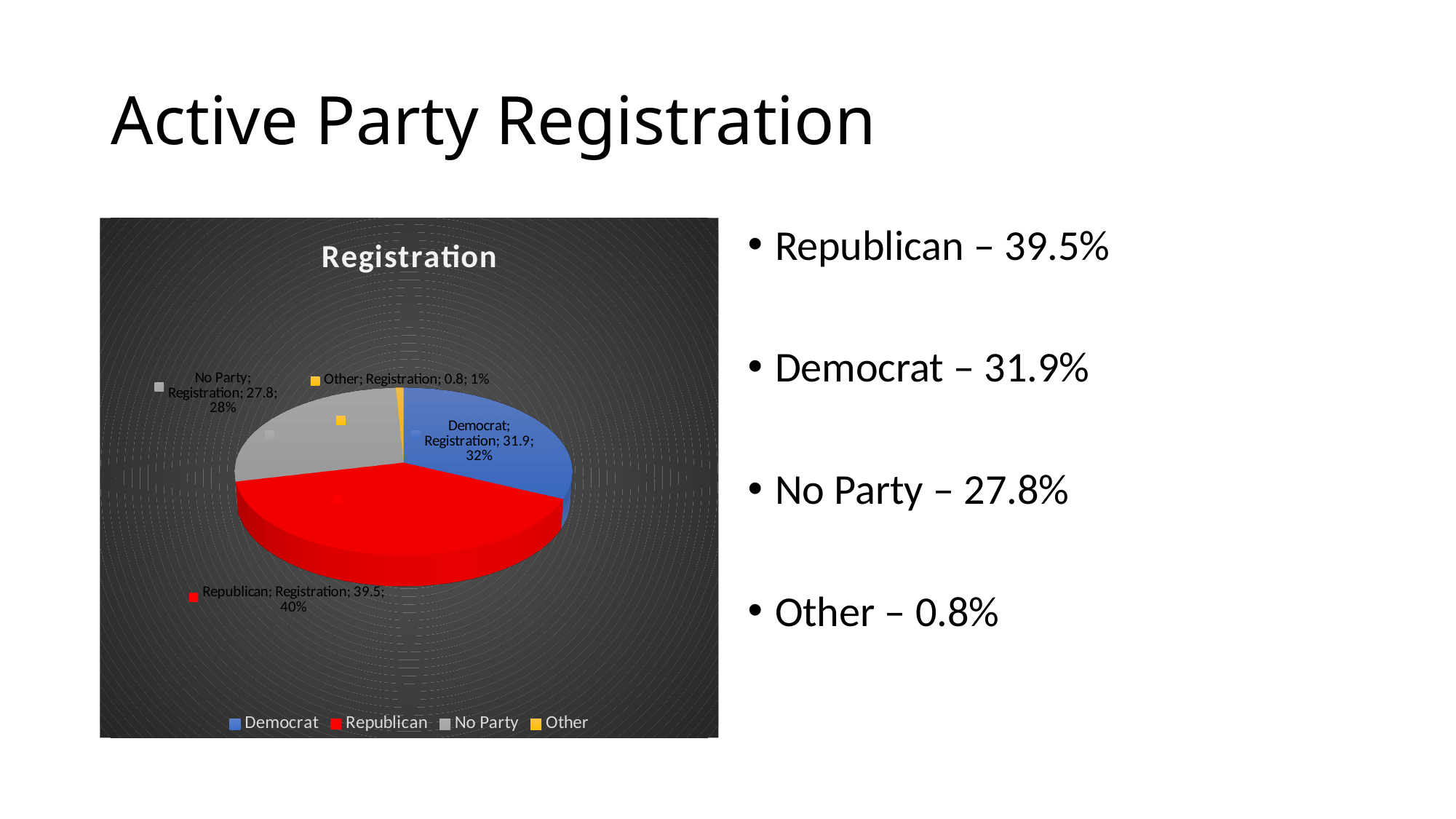
What is the Registration value for Republican in the pie chart? 39.5 What percentage share of the pie does No Party have, as labelled on the chart? 28% How many categories does the pie chart show? 4 Which category has the smallest slice in the pie chart? Other What type of chart is shown on the slide? Pie chart What is the Registration value for Democrat in the pie chart? 31.9 Which category has the largest slice in the pie chart? Republican What percentage share of the pie does Democrat have, as labelled on the chart? 32% What is the Registration value for Other in the pie chart? 0.8 What is the difference between the Republican and Democrat Registration values? 7.6 What is the Registration value for No Party in the pie chart? 27.8 Which is larger, the Democrat value or the No Party value? Democrat